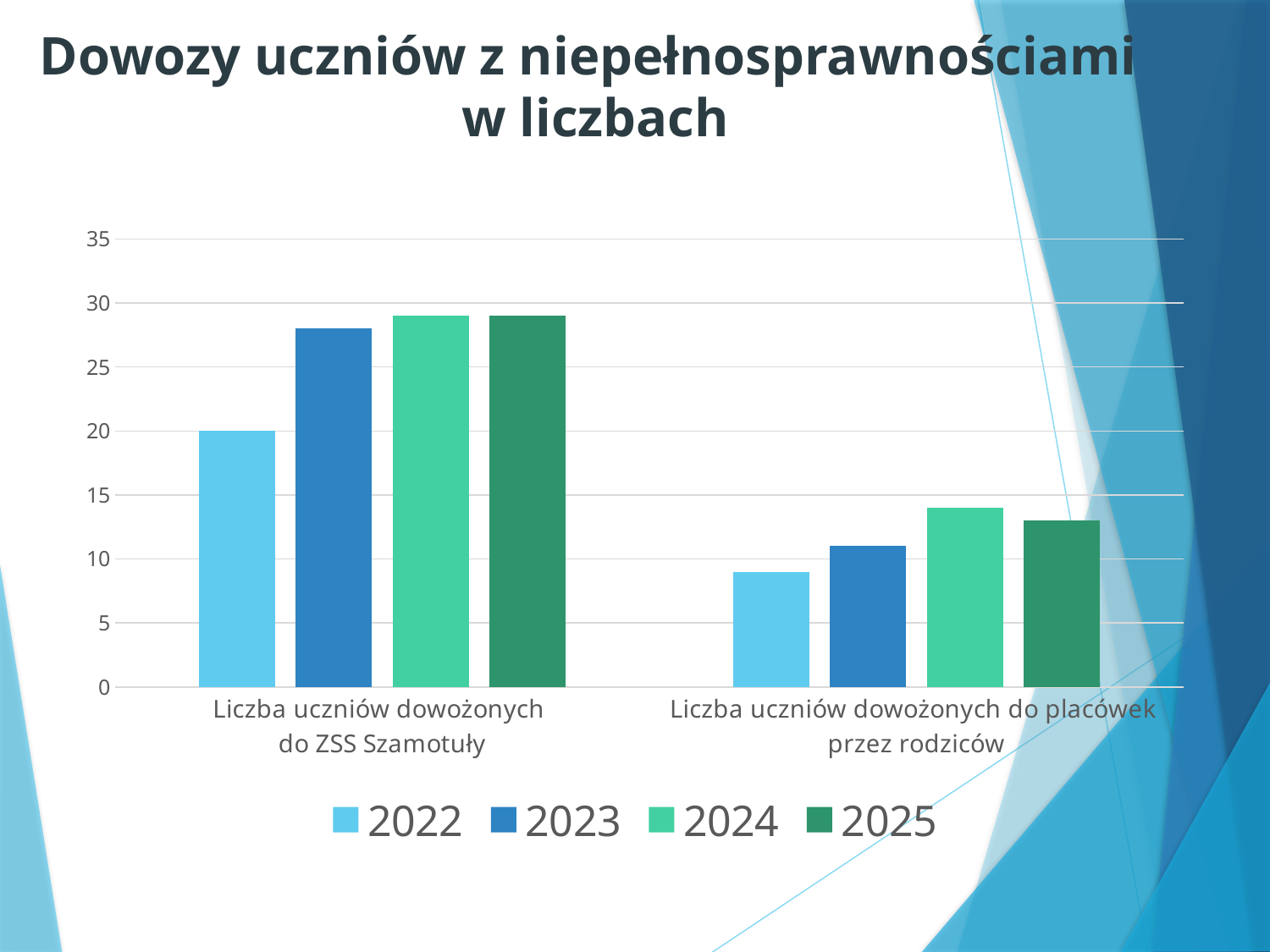
What type of chart is shown on the slide? bar chart How many categories are shown on the x axis? 2 Is the value for 2022 in the category 'Liczba uczniów dowożonych do placówek przez rodziców' greater or less than 10? less From 2022 to 2024, do the values in the category 'Liczba uczniów dowożonych do placówek przez rodziców' rise or fall? rise What is the value for 2022 in the category 'Liczba uczniów dowożonych do ZSS Szamotuły'? 20 What is the title of the chart on the slide? Dowozy uczniów z niepełnosprawnościami w liczbach Which year has the lowest value in the category 'Liczba uczniów dowożonych do placówek przez rodziców'? 2022 Is the value for 2023 in the category 'Liczba uczniów dowożonych do ZSS Szamotuły' greater or less than 25? greater How many series does the legend list? 4 Which year has the lowest value in the category 'Liczba uczniów dowożonych do ZSS Szamotuły'? 2022 Is the value for 2024 in the category 'Liczba uczniów dowożonych do placówek przez rodziców' greater or less than 15? less Which is larger: the 2022 value or the 2023 value in the category 'Liczba uczniów dowożonych do ZSS Szamotuły'? 2023